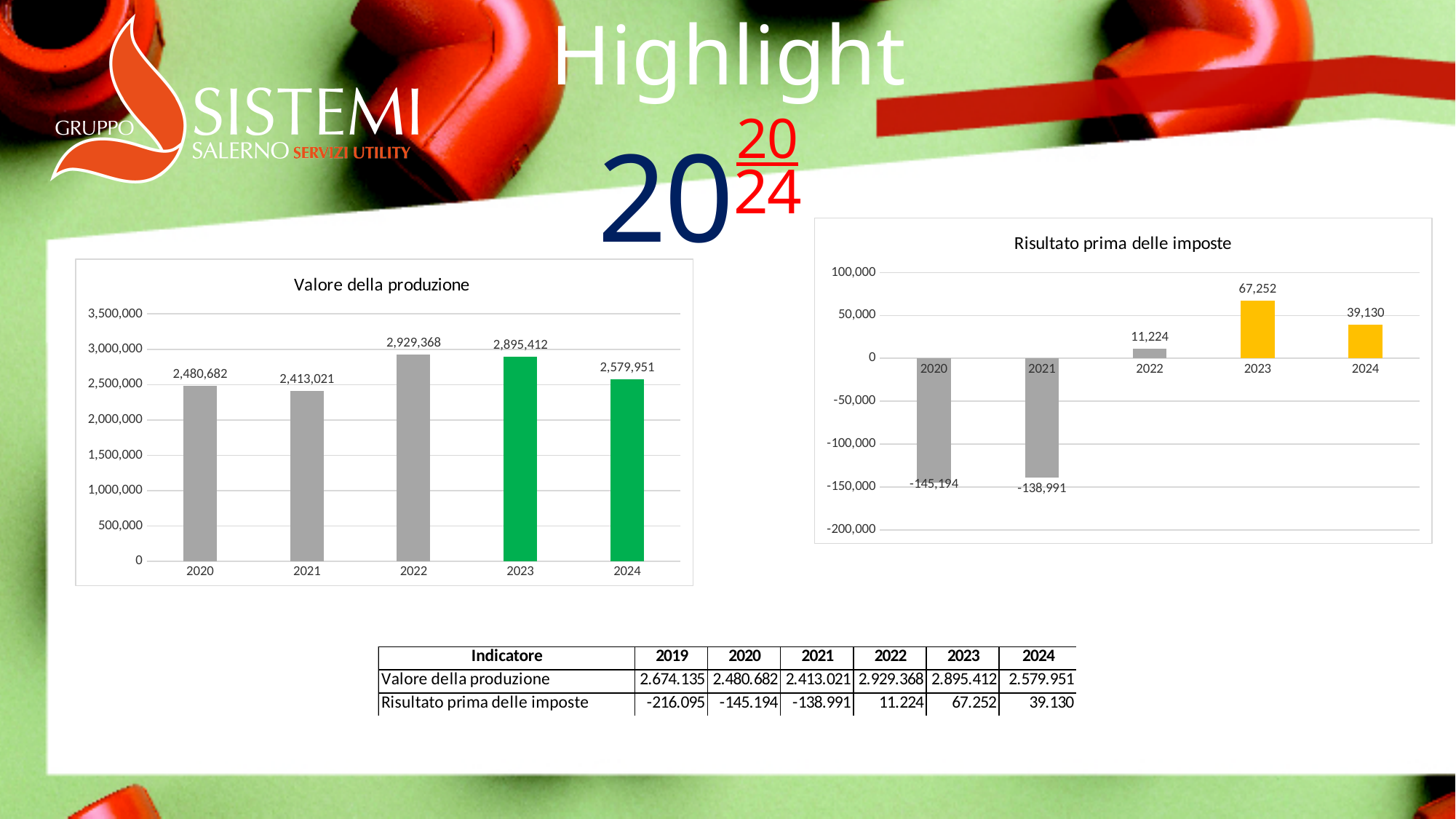
What kind of chart is the 'Risultato prima delle imposte' chart? bar chart In the 'Risultato prima delle imposte' chart, what is the value for 2020? -145,194 In the 'Valore della produzione' chart, what is the difference between the 2022 and 2023 values? 33,956 In the 'Valore della produzione' chart, which year has the highest value? 2022 In the 'Valore della produzione' chart, how many years are shown on the x axis? 5 In the 'Valore della produzione' chart, what is the value for 2024? 2,579,951 In the 'Risultato prima delle imposte' chart, which year has the lowest value? 2020 In the 'Valore della produzione' chart, which year has the lowest value? 2021 In the 'Risultato prima delle imposte' chart, what is the value for 2023? 67,252 In the 'Risultato prima delle imposte' chart, is the value for 2022 larger or smaller than the value for 2024? smaller In the 'Risultato prima delle imposte' chart, what is the difference between the 2023 and 2024 values? 28,122 In the 'Valore della produzione' chart, what is the value for 2022? 2,929,368